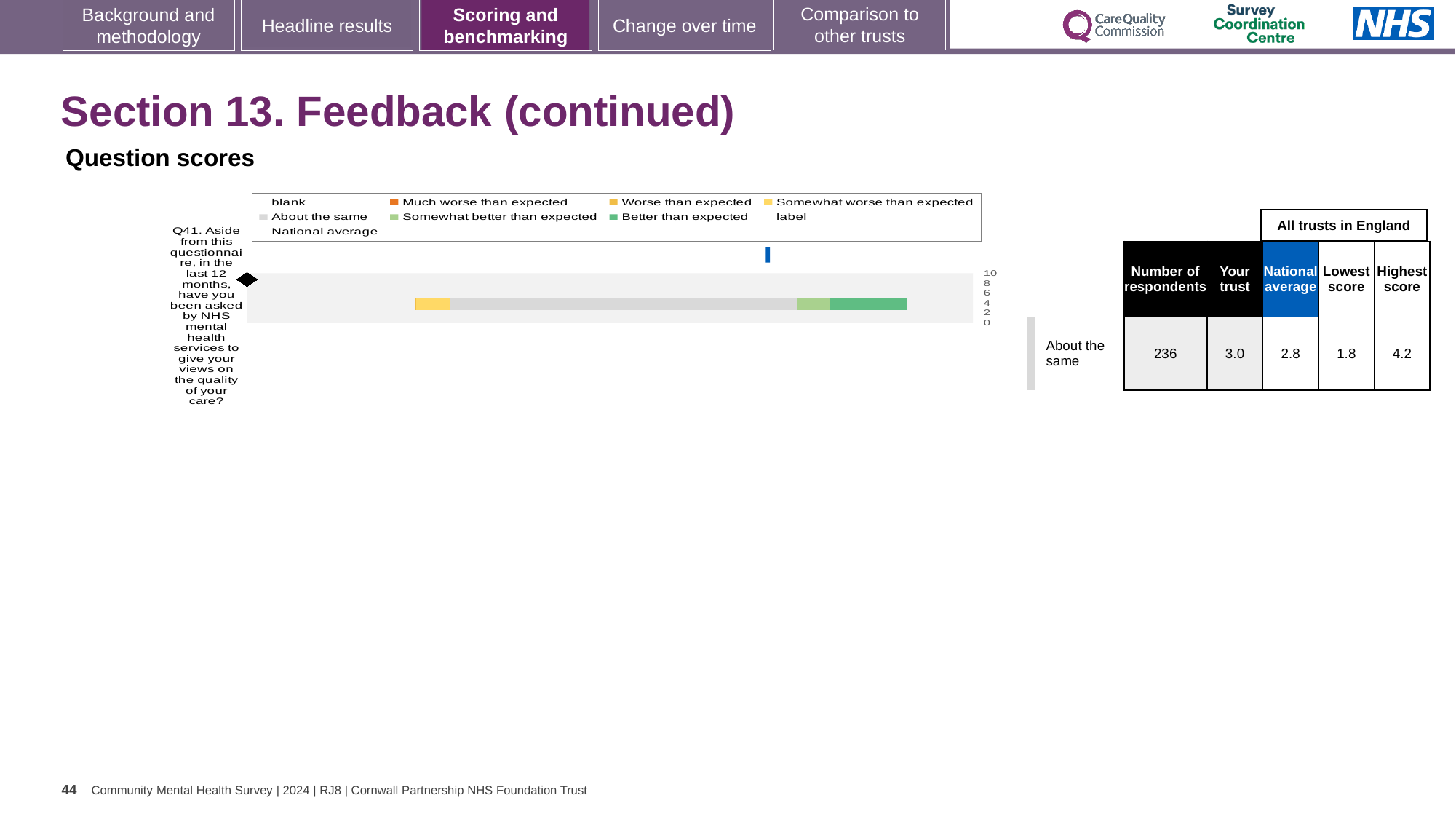
In the table next to the chart, which is larger for Q41: the 'Your trust' score or the national average? Your trust Which question is plotted in the chart? Q41. Aside from this questionnaire, in the last 12 months, have you been asked by NHS mental health services to give your views on the quality of your care? In the chart legend, which colour represents 'About the same'? grey What kind of chart is shown on the slide? bar chart In the table next to the chart, what is the lowest score among all trusts in England for Q41? 1.8 In the table next to the chart, what is the national average score for Q41? 2.8 In the table next to the chart, what is the highest score among all trusts in England for Q41? 4.2 In the table next to the chart, what is the 'Your trust' score for Q41? 3.0 In the table next to the chart, what is the number of respondents for Q41? 236 In the table next to the chart, what benchmark category is given for Q41? About the same How many questions (categories) are plotted in the chart? 1 In the table next to the chart, what is the difference between the highest score and the lowest score for Q41? 2.4